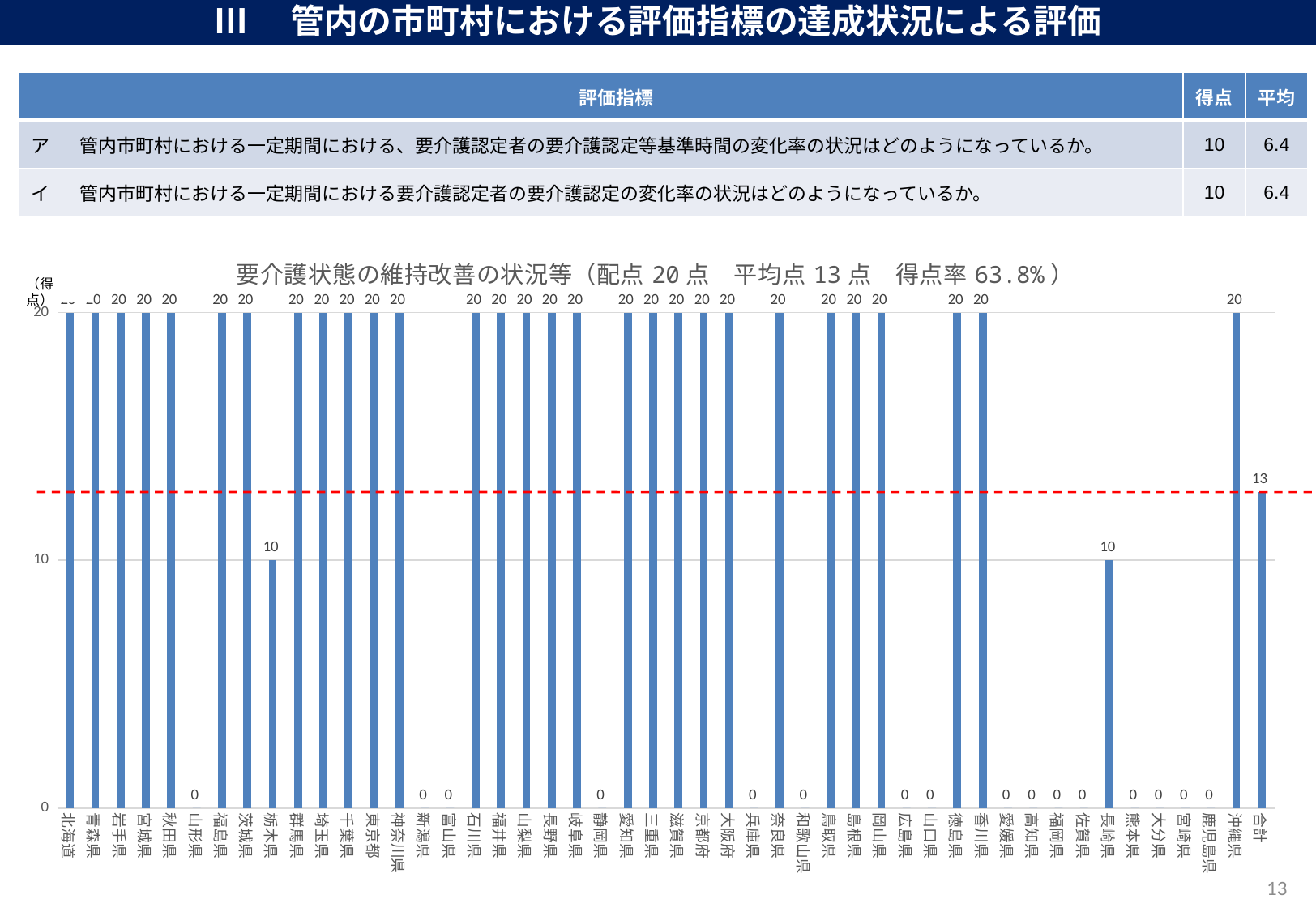
How many categories are shown on the x axis of the chart? 48 What is the value for 長崎県 in the chart? 10 What is the value for 栃木県 in the chart? 10 Is the value for 合計 greater or less than 10? greater What is the value for 北海道 in the chart? 20 What kind of chart is shown on the slide? bar chart What is the title of the chart? 要介護状態の維持改善の状況等（配点 20 点 平均点 13 点 得点率 63.8%） What is the value for 山形県 in the chart? 0 What is the value for 合計 in the chart? 13 What is the difference between the values for 沖縄県 and 合計? 7 Which is larger, the value for 沖縄県 or the value for 長崎県? 沖縄県 What is the difference between the values for 北海道 and 栃木県? 10